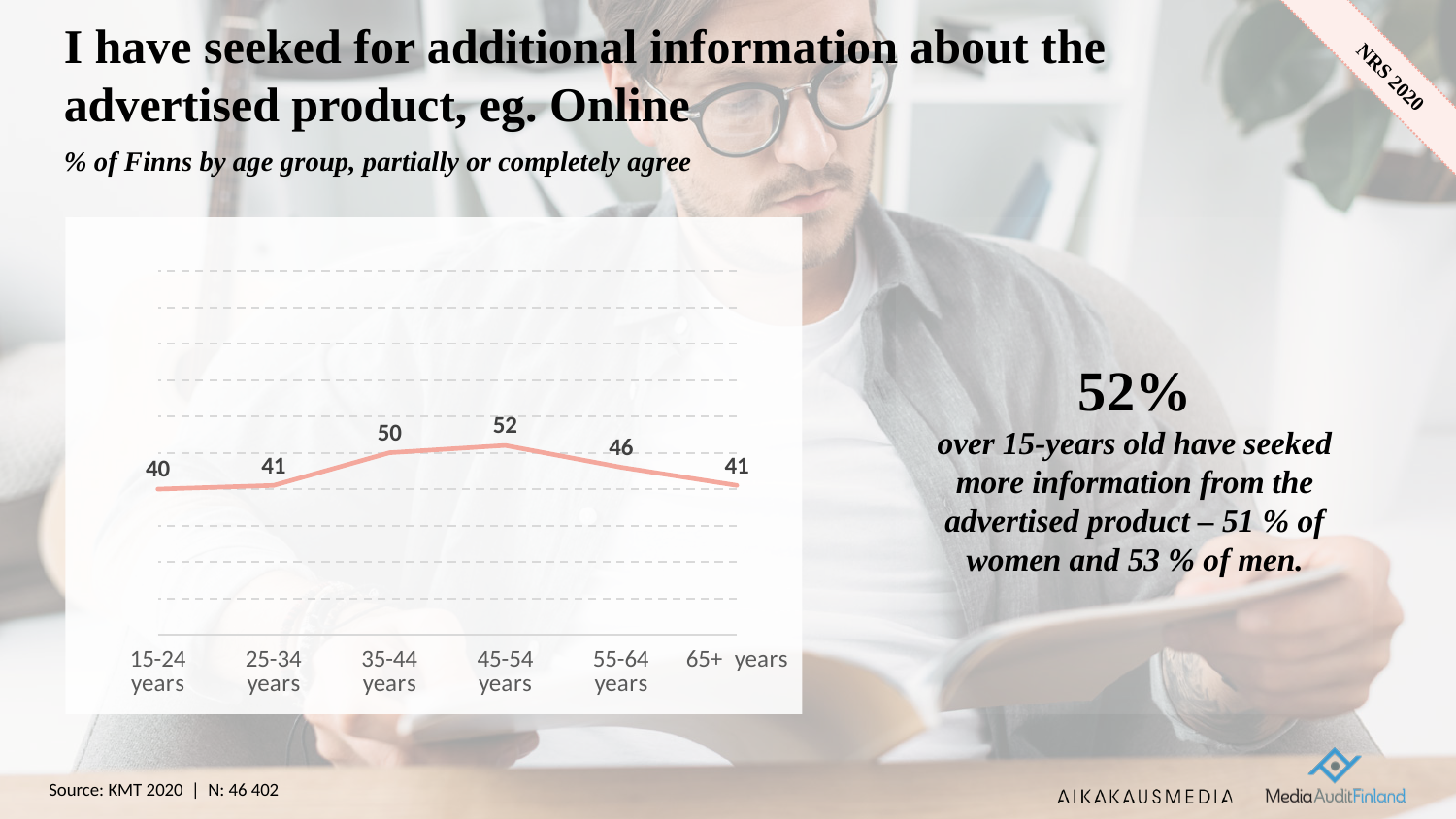
Which age group has the highest value? 45-54 years What kind of chart is shown on the slide? Line chart Which is larger, the value for 35-44 years or the value for 55-64 years? 35-44 years What is the value for the 35-44 years age group? 50 How many age groups are plotted on the chart? 6 What is the title of the chart on the slide? I have seeked for additional information about the advertised product, eg. Online What is the value for the 65+ years age group? 41 What is the difference between the values for the 35-44 years and 55-64 years age groups? 4 What is the difference between the values for the 45-54 years and 15-24 years age groups? 12 What is the value for the 55-64 years age group? 46 Which age group has the lowest value? 15-24 years Do the values rise or fall from the 45-54 years group to the 65+ years group? Fall